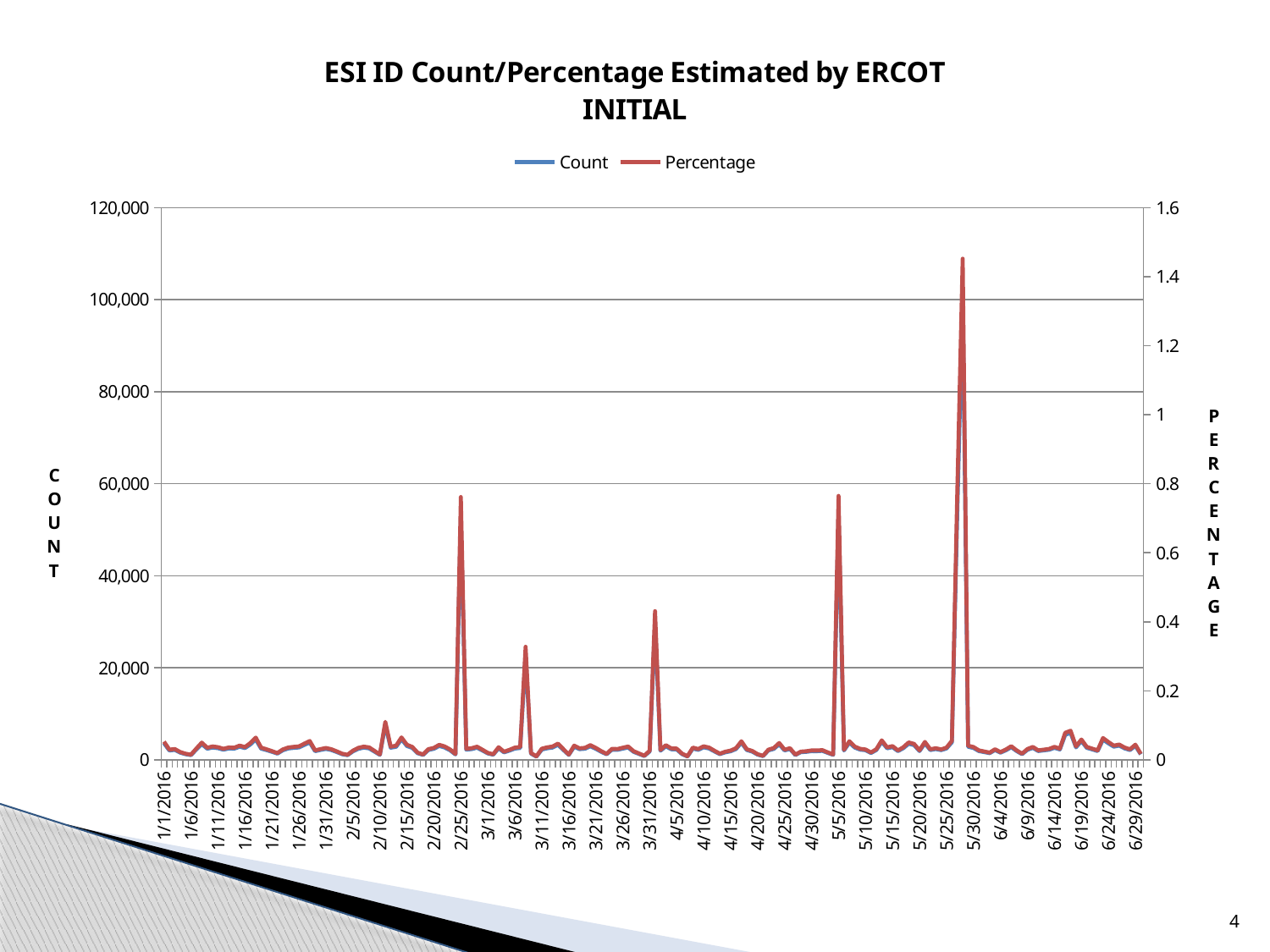
Is the Count spike near 3/31/2016 greater or less than 40,000? less Is the Percentage value at the tallest spike (between 5/25/2016 and 5/30/2016) greater or less than 1.2? greater Which is larger: the Count spike near 5/5/2016 or the Count spike near 3/31/2016? the spike near 5/5/2016 Is the Count spike near 2/25/2016 greater or less than 40,000? greater What is the title of the chart? ESI ID Count/Percentage Estimated by ERCOT INITIAL What are the two series named in the legend? Count and Percentage How many series does the legend list? 2 What is the maximum value shown on the left (Count) axis? 120,000 What kind of chart is shown on the slide? line chart